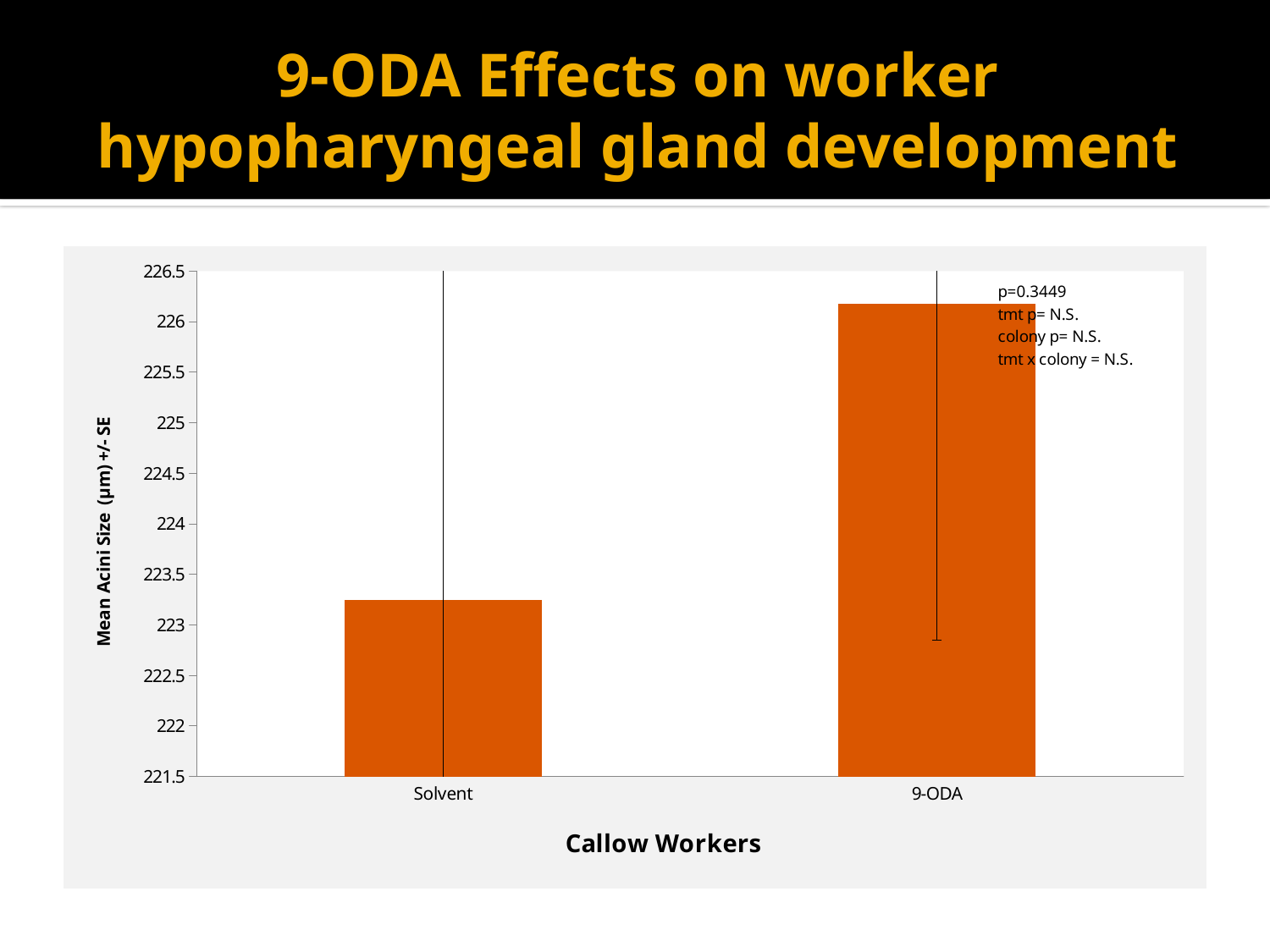
Is the value for Solvent greater or less than 223? greater Is the value for 9-ODA greater or less than 226.5? less How many categories are plotted on the x axis? 2 What kind of chart is shown on the slide? bar chart Is the value for 9-ODA greater or less than 226? greater What is the y-axis title of the chart? Mean Acini Size (µm) +/- SE What is the x-axis title of the chart? Callow Workers What is the lowest value shown on the y axis? 221.5 Which category has the lowest mean acini size? Solvent Which is larger, the value for Solvent or the value for 9-ODA? 9-ODA Which category has the highest mean acini size? 9-ODA